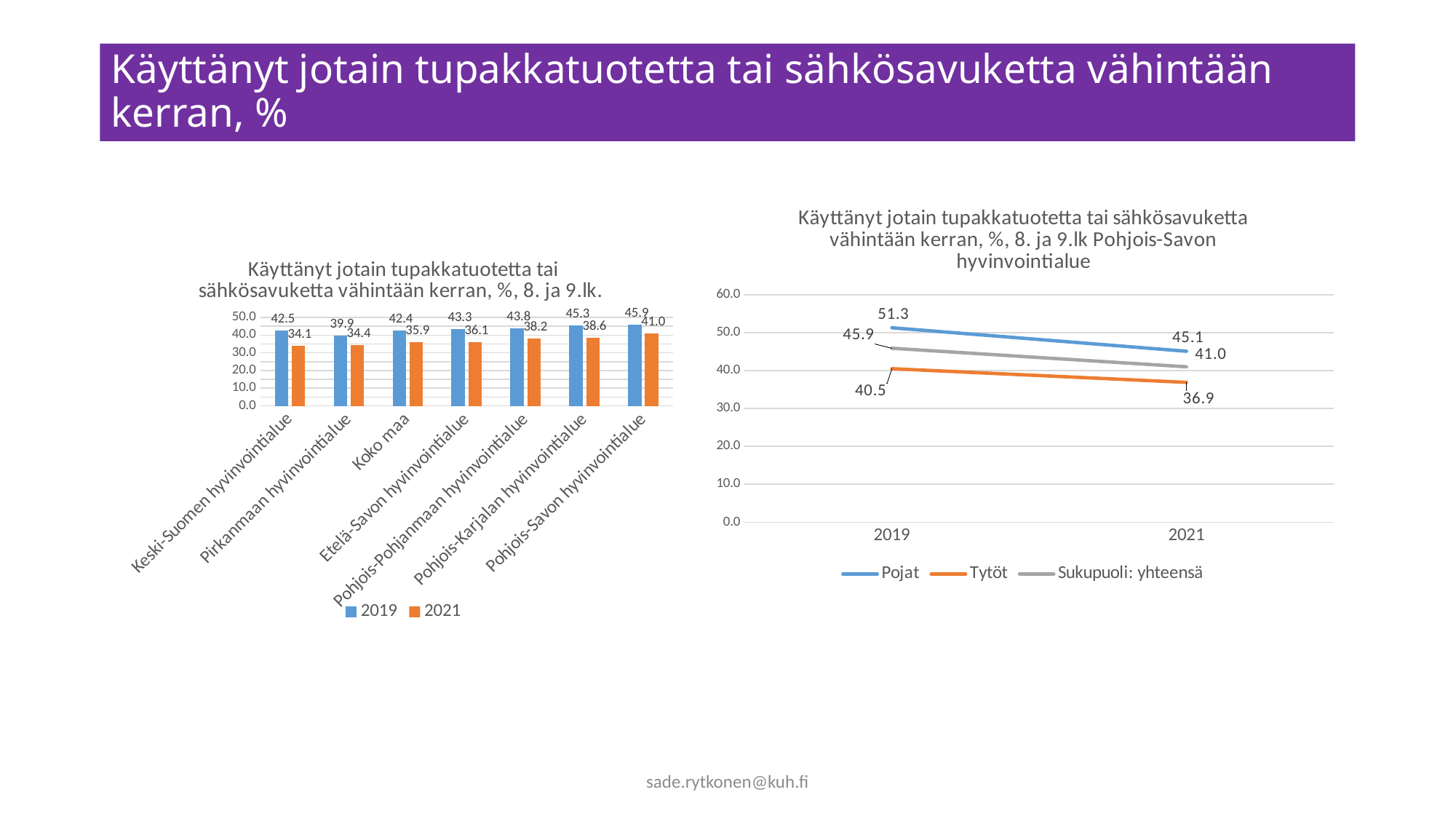
In the left bar chart, what is the 2019 value for Keski-Suomen hyvinvointialue? 42.5 In the left bar chart, what is the difference between the 2019 and 2021 values for Pohjois-Karjalan hyvinvointialue? 6.7 What kind of chart is the chart on the left? Bar chart In the left bar chart, which is larger: the 2021 value for Pohjois-Pohjanmaan hyvinvointialue or the 2021 value for Etelä-Savon hyvinvointialue? Pohjois-Pohjanmaan hyvinvointialue In the right line chart, what is the value for Pojat in 2019? 51.3 In the left bar chart, which category has the lowest 2021 value? Keski-Suomen hyvinvointialue In the left bar chart, what is the 2021 value for Koko maa? 35.9 In the left bar chart, which category has the highest 2019 value? Pohjois-Savon hyvinvointialue In the right line chart, does the value for Sukupuoli: yhteensä rise or fall from 2019 to 2021? Fall In the left bar chart, how many categories are shown on the x axis? 7 In the right line chart, how many series does the legend list? 3 In the right line chart, what is the value for Tytöt in 2021? 36.9